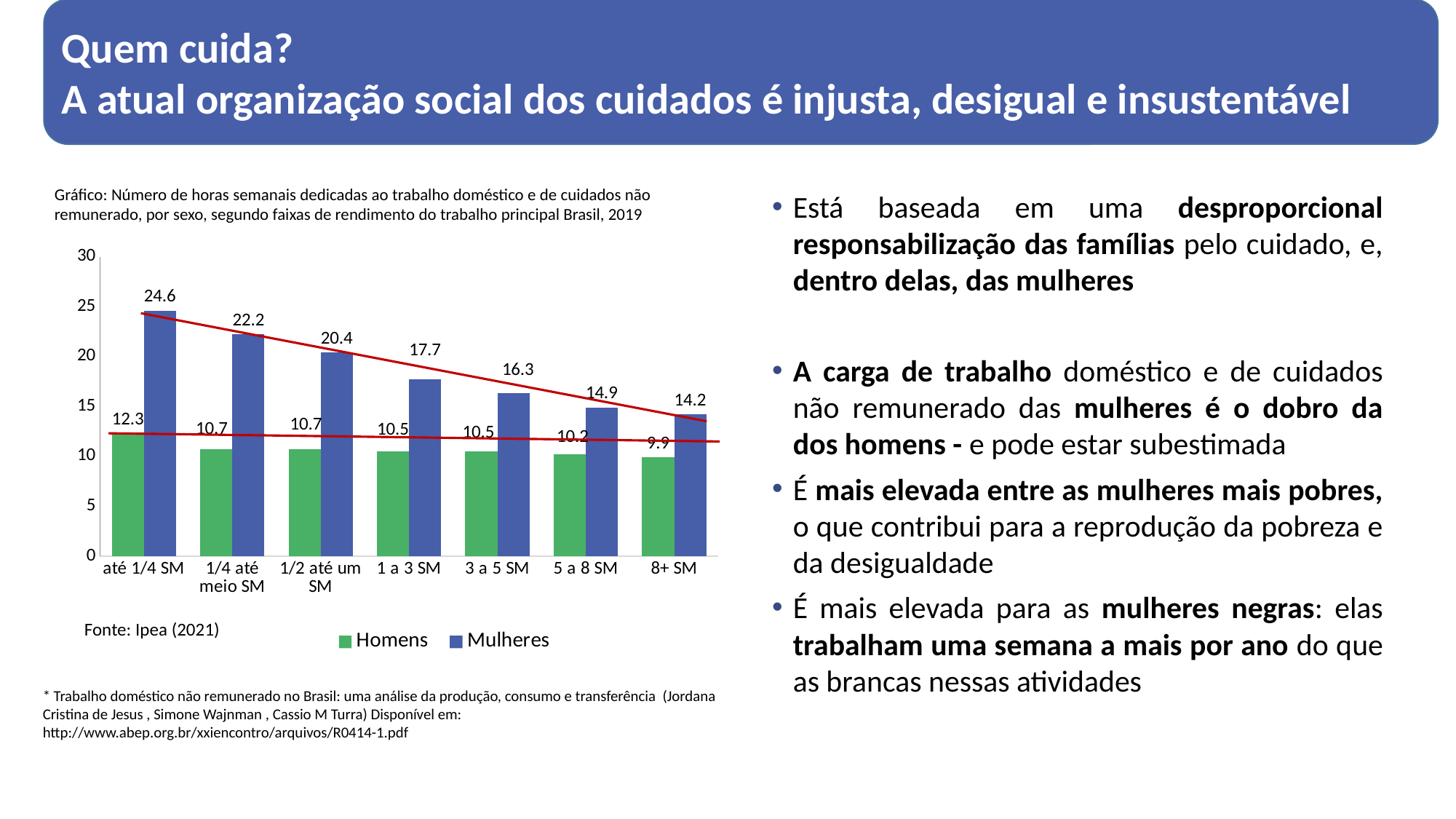
What is the difference between the Mulheres and Homens values in the 'até 1/4 SM' category? 12.3 What is the value for Homens in the '8+ SM' category? 9.9 What is the value for Mulheres in the '1 a 3 SM' category? 17.7 What is the value for Mulheres in the 'até 1/4 SM' category? 24.6 Which income category has the highest value for Mulheres? até 1/4 SM How many series does the legend list? 2 Which is larger in the '3 a 5 SM' category, Homens or Mulheres? Mulheres Which income category has the lowest value for Homens? 8+ SM What kind of chart is shown on the slide? Bar chart How many income categories are shown on the x axis? 7 What colour are the Homens bars? Green Do the Mulheres values rise or fall as income increases along the x axis? Fall